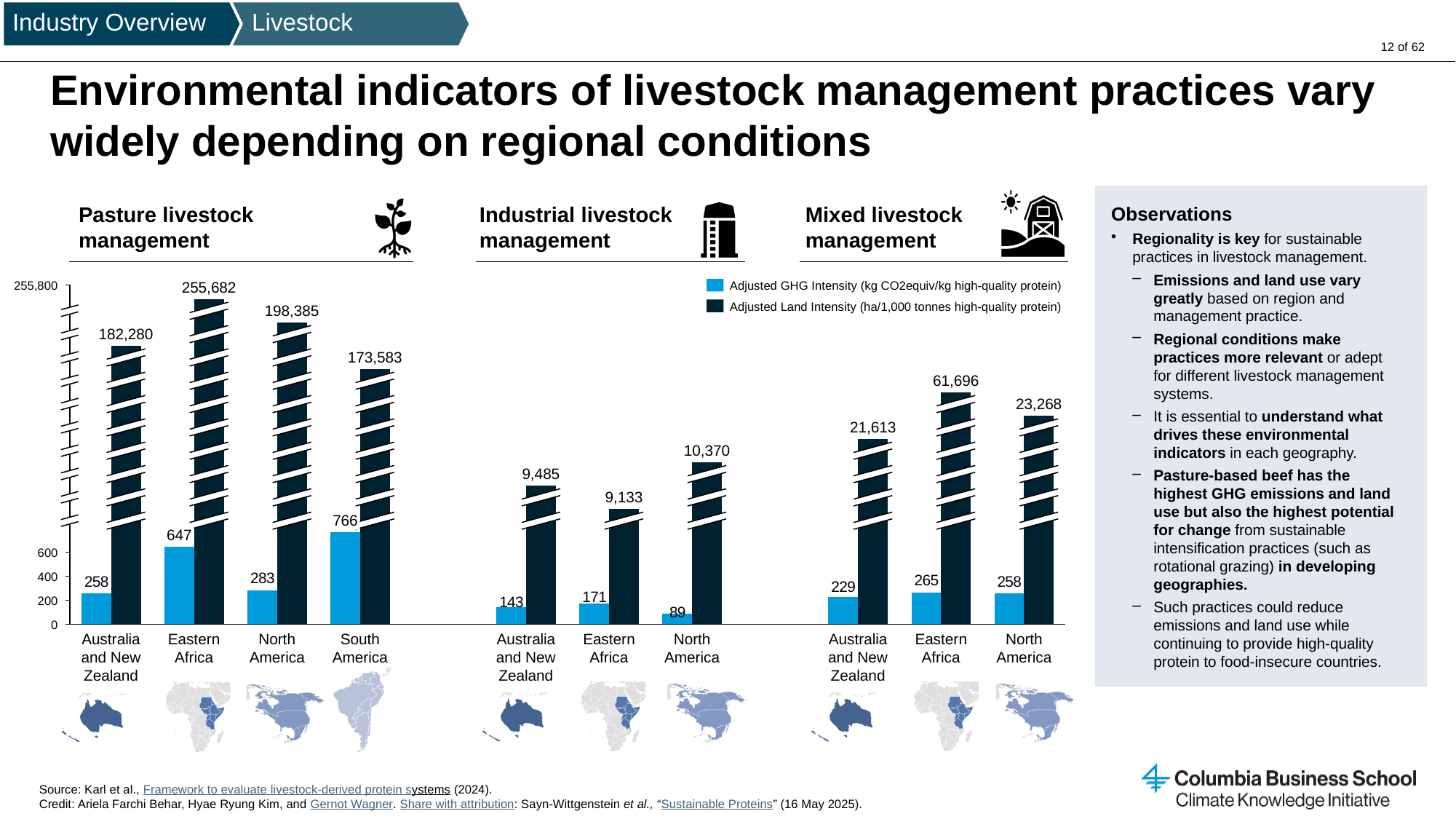
How many series does the legend list for the charts? 2 In the Pasture livestock management chart, what is the Adjusted GHG Intensity for South America? 766 In the Industrial livestock management chart, what is the Adjusted GHG Intensity for North America? 89 In the Mixed livestock management chart, what is the Adjusted Land Intensity for Eastern Africa? 61,696 What type of chart is used for the Mixed livestock management data? Bar chart In the Industrial livestock management chart, which is larger: the Adjusted Land Intensity for North America or for Eastern Africa? North America In the Pasture livestock management chart, which region has the highest Adjusted Land Intensity? Eastern Africa How many regions are shown in the Pasture livestock management chart? 4 In the Mixed livestock management chart, what is the difference in Adjusted Land Intensity between Eastern Africa and Australia and New Zealand? 40,083 In the Pasture livestock management chart, what is the Adjusted Land Intensity for Eastern Africa? 255,682 In the Industrial livestock management chart, which region has the lowest Adjusted GHG Intensity? North America Which colour represents Adjusted GHG Intensity in the legend? Light blue